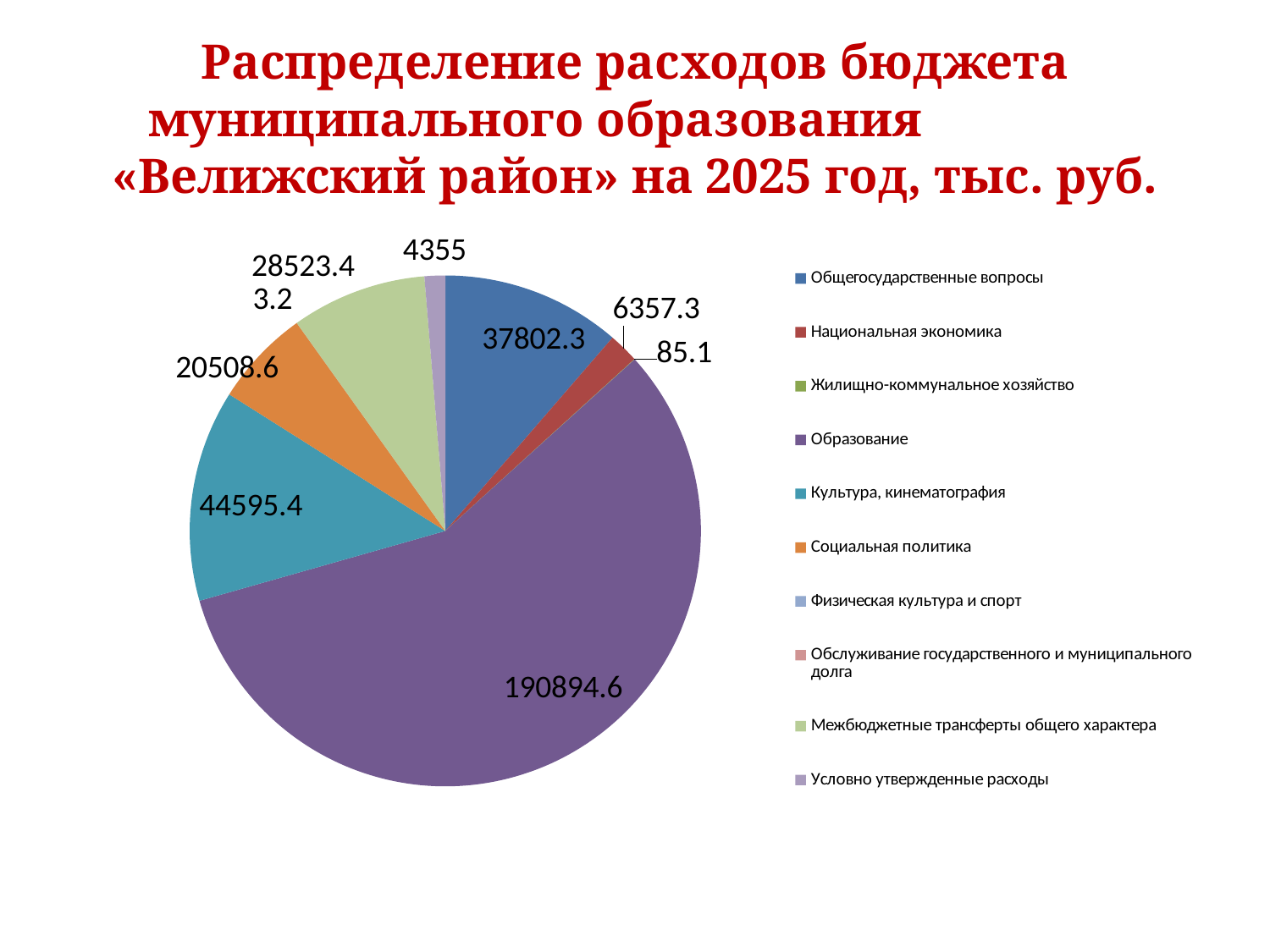
What is the value for Межбюджетные трансферты общего характера? 28523.4 Which category has the largest slice of the pie? Образование What is the value for Культура, кинематография? 44595.4 How many categories does the legend list? 10 Which is larger, Культура, кинематография or Социальная политика? Культура, кинематография What is the value for Образование? 190894.6 What is the value for Общегосударственные вопросы? 37802.3 What is the value for Национальная экономика? 6357.3 What is the value for Условно утвержденные расходы? 4355 What is the difference between the values for Культура, кинематография and Общегосударственные вопросы? 6793.1 What is the value for Социальная политика? 20508.6 What type of chart is shown on the slide? pie chart